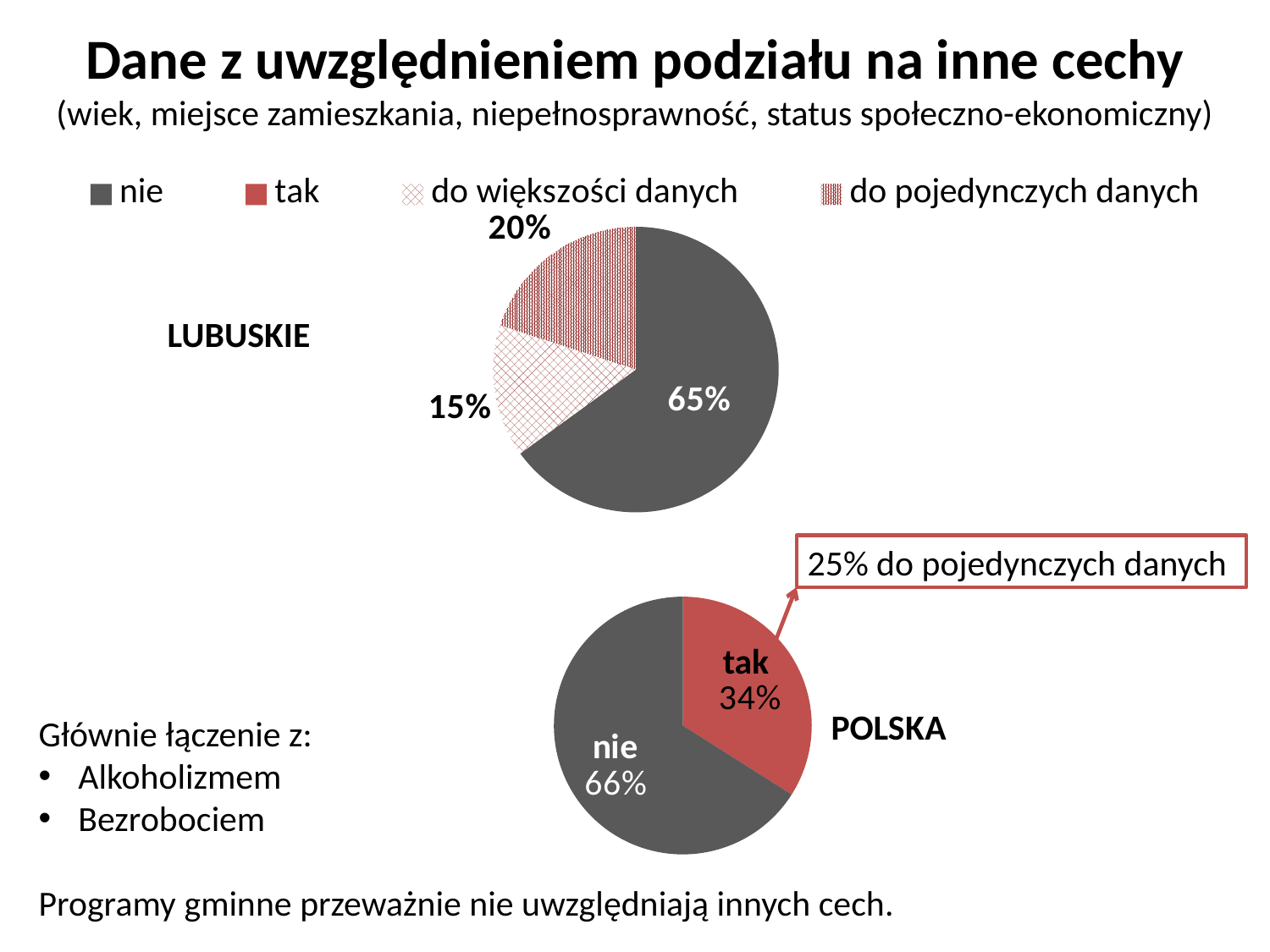
In the LUBUSKIE pie chart, what share is shown for "do pojedynczych danych"? 20% In the LUBUSKIE pie chart, which slice is the largest? nie In the POLSKA pie chart, what share is labelled for "nie"? 66% In the POLSKA pie chart, what share is labelled for "tak"? 34% In the LUBUSKIE pie chart, what share is labelled for "nie"? 65% In the POLSKA pie chart, what is the difference between the "nie" share and the "tak" share? 32% In the LUBUSKIE pie chart, what share is shown for "do większości danych"? 15% In the LUBUSKIE pie chart, which slice is the smallest? do większości danych In the LUBUSKIE pie chart, what is the difference between the "nie" share and the "do pojedynczych danych" share? 45% How many entries does the legend at the top of the slide list? 4 How many slices does the LUBUSKIE pie chart have? 3 Which is larger in the POLSKA pie chart: "nie" or "tak"? nie